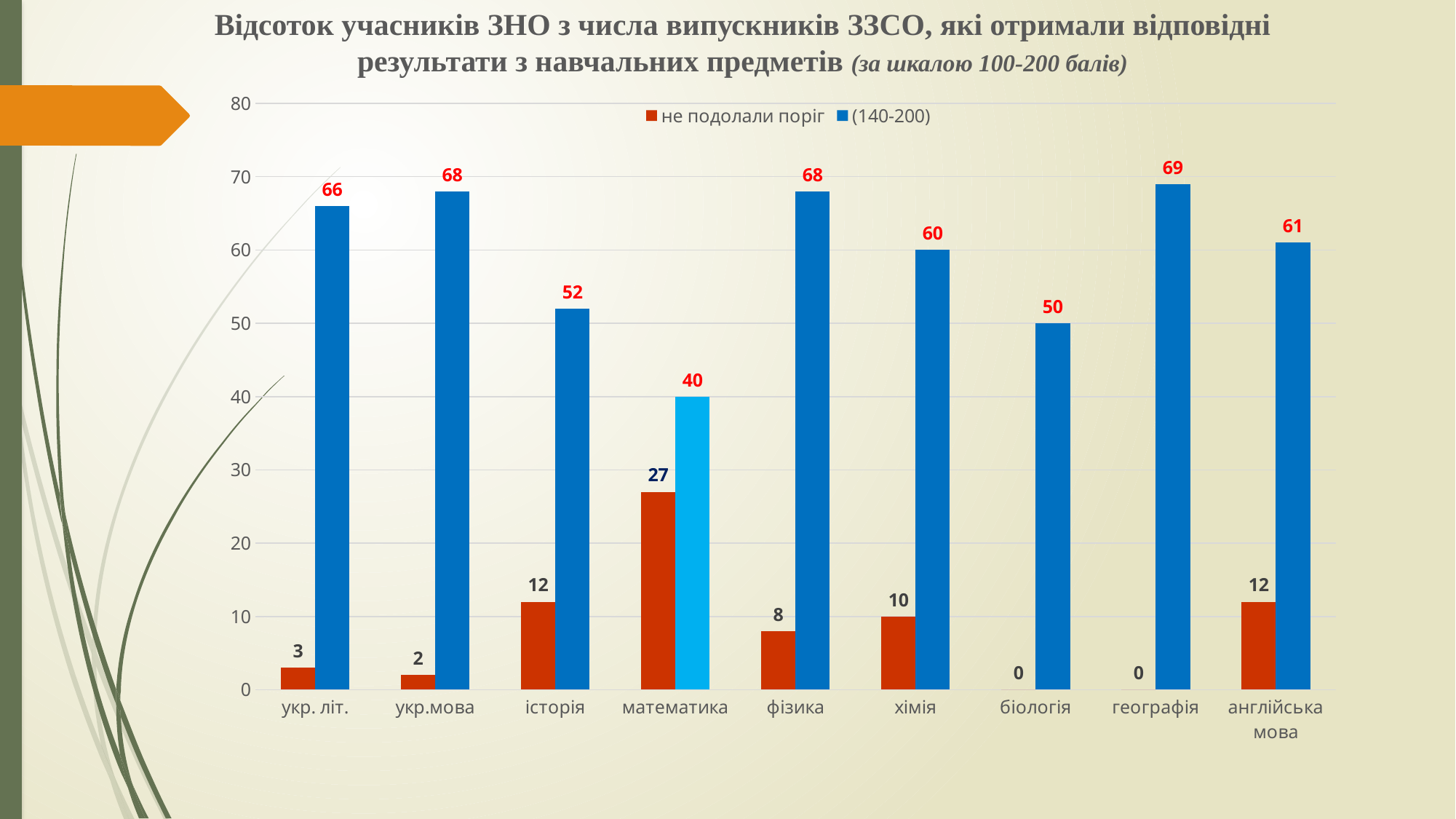
How many categories are shown on the x axis? 9 Which category has the highest value in the (140-200) series? географія Which category has the lowest value in the (140-200) series? математика What kind of chart is shown on the slide? bar chart What is the value for математика in the (140-200) series? 40 What colour are the bars for the (140-200) series? blue Which is larger: the (140-200) value for фізика or for англійська мова? фізика What is the value for історія in the 'не подолали поріг' series? 12 What is the difference between the (140-200) values for укр.мова and хімія? 8 What is the 'не подолали поріг' value for біологія? 0 How many series does the legend list? 2 Which category has the highest value in the 'не подолали поріг' series? математика